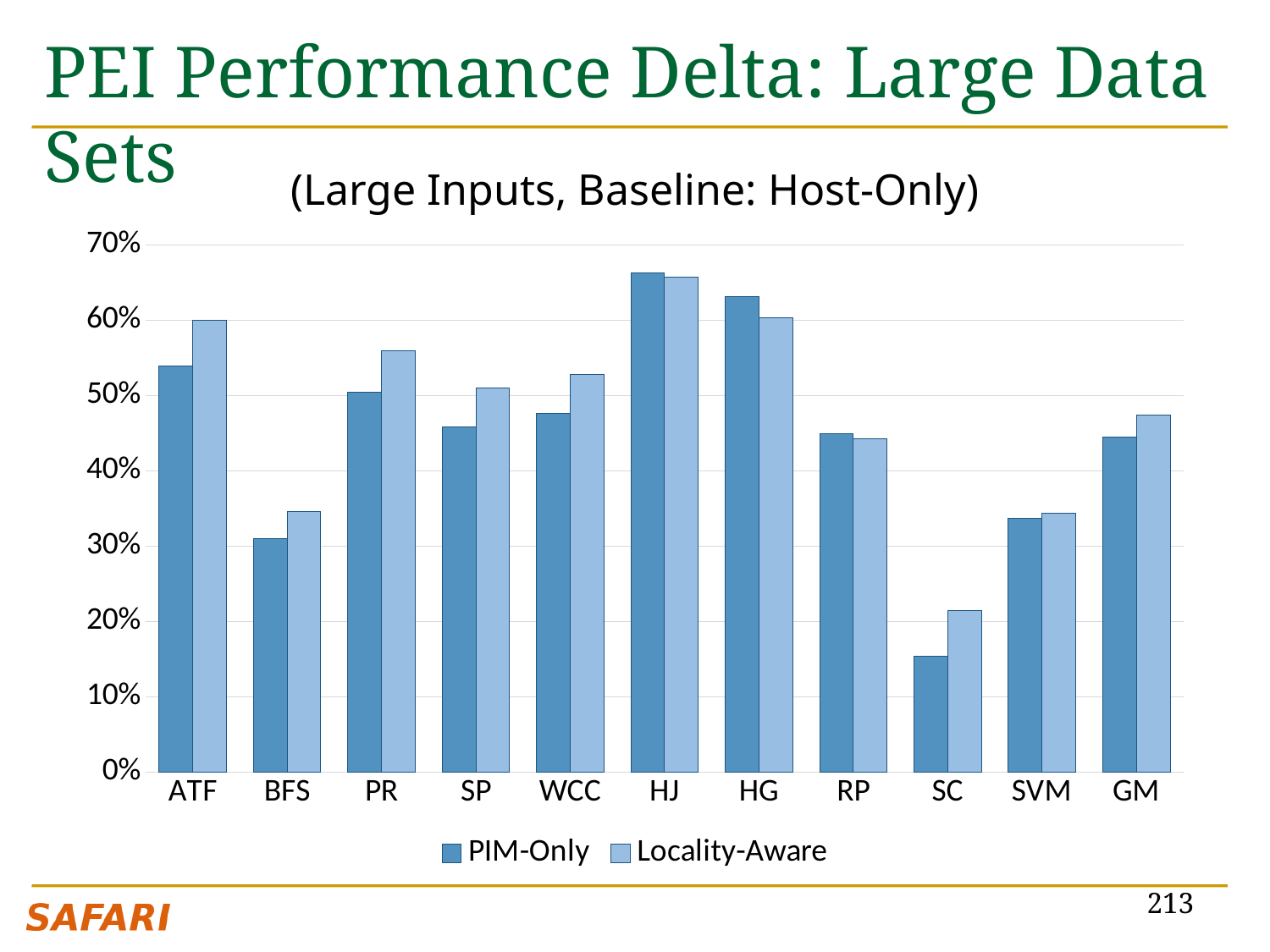
Which category has the lowest Locality-Aware value? SC How many series does the legend list? 2 Is the Locality-Aware value for SC greater or less than 30%? less What kind of chart is shown on the slide? bar chart For ATF, which is larger: the PIM-Only value or the Locality-Aware value? Locality-Aware Which category has the lowest PIM-Only value? SC What are the two series named in the legend? PIM-Only and Locality-Aware Which category has the highest PIM-Only value? HJ For HG, which is larger: the PIM-Only value or the Locality-Aware value? PIM-Only Is the PIM-Only value for ATF greater or less than 50%? greater Is the PIM-Only value for HG greater or less than 60%? greater How many categories are shown along the x axis? 11